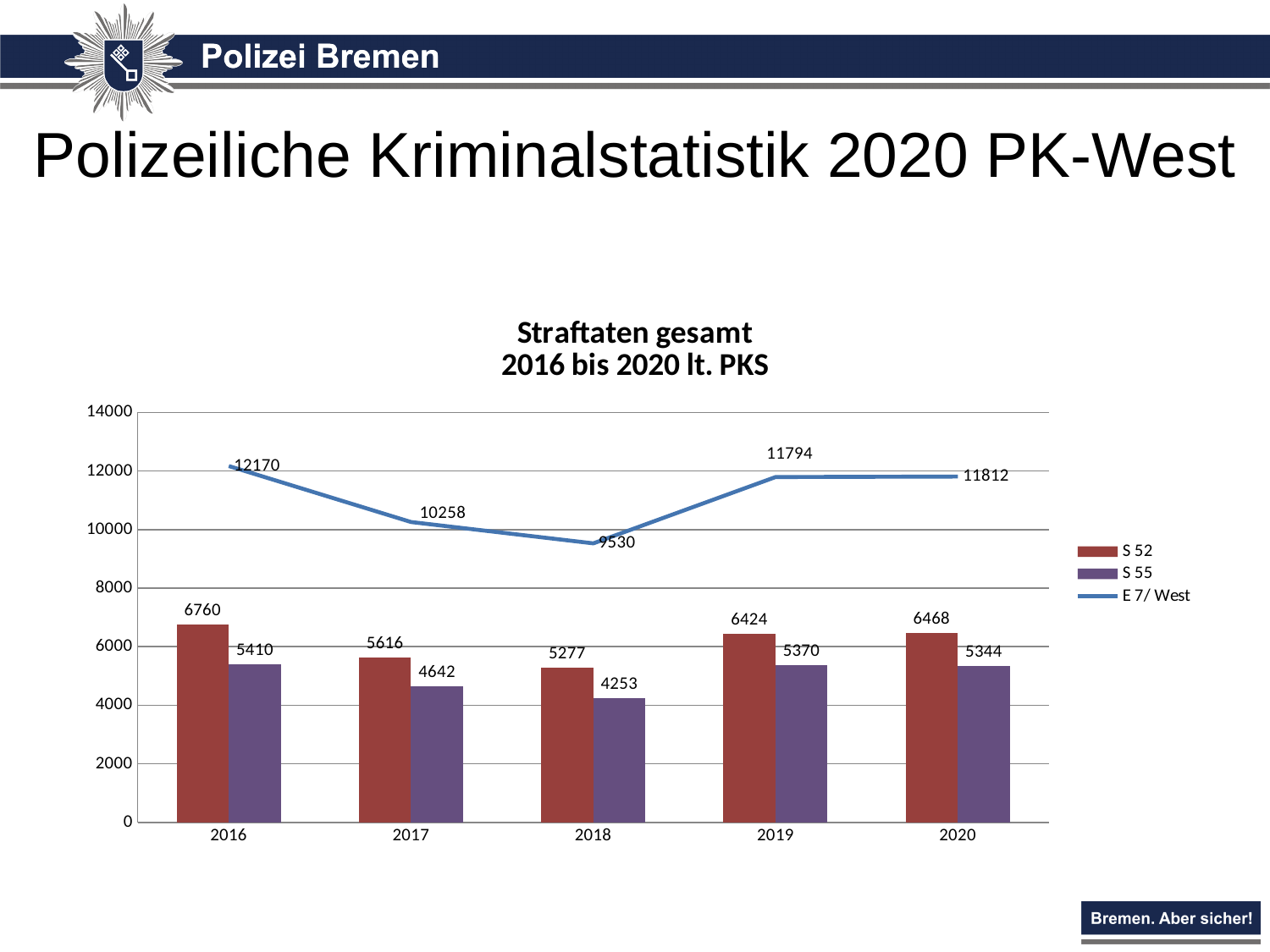
What is the value for S 52 in 2016? 6760 What is the difference between the S 52 and S 55 values in 2020? 1124 How many years are shown on the x axis? 5 What is the value for E 7/ West in 2019? 11794 In which year is the E 7/ West value lowest? 2018 Which is larger, the S 55 value in 2017 or the S 55 value in 2019? 2019 In which year is the S 52 value highest? 2016 How does the E 7/ West value change from 2016 to 2018? It falls What is the value for S 55 in 2018? 4253 Is the value for E 7/ West in 2017 greater or less than 10000? greater What is the title of the chart? Straftaten gesamt 2016 bis 2020 lt. PKS How many series does the legend list? 3